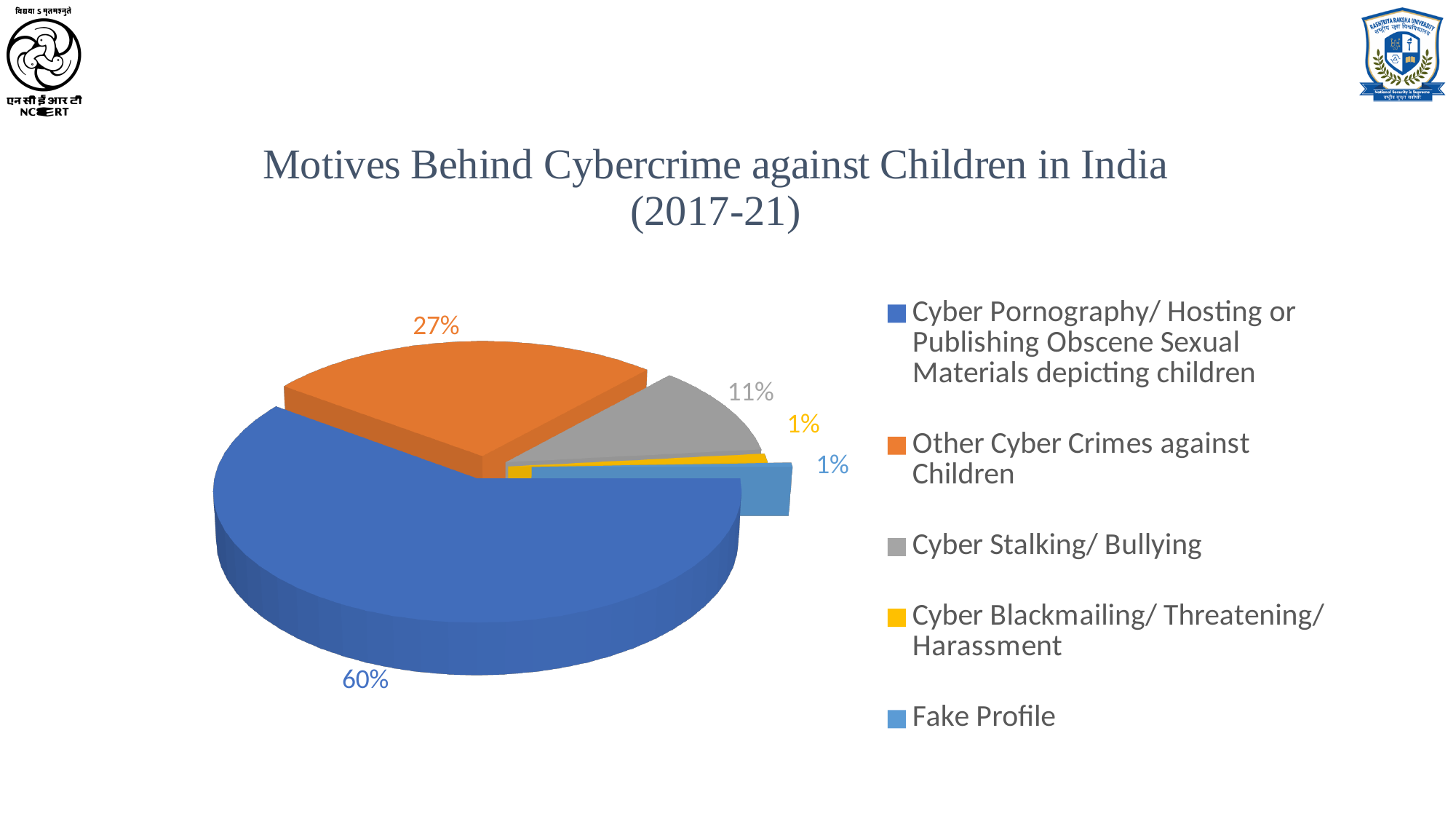
What is the difference in percentage points between Cyber Pornography/ Hosting or Publishing Obscene Sexual Materials depicting children and Other Cyber Crimes against Children? 33 What colour is the slice for Cyber Stalking/ Bullying? Grey Which is larger: Other Cyber Crimes against Children or Cyber Stalking/ Bullying? Other Cyber Crimes against Children What share of the pie is Cyber Pornography/ Hosting or Publishing Obscene Sexual Materials depicting children? 60% How many categories does the legend list? 5 What share of the pie is Fake Profile? 1% What is the title of the chart? Motives Behind Cybercrime against Children in India (2017-21) What is the difference in percentage points between Cyber Stalking/ Bullying and Cyber Blackmailing/ Threatening/ Harassment? 10 What share of the pie is Other Cyber Crimes against Children? 27% Which category has the largest share of the pie? Cyber Pornography/ Hosting or Publishing Obscene Sexual Materials depicting children What type of chart is shown on the slide? Pie chart